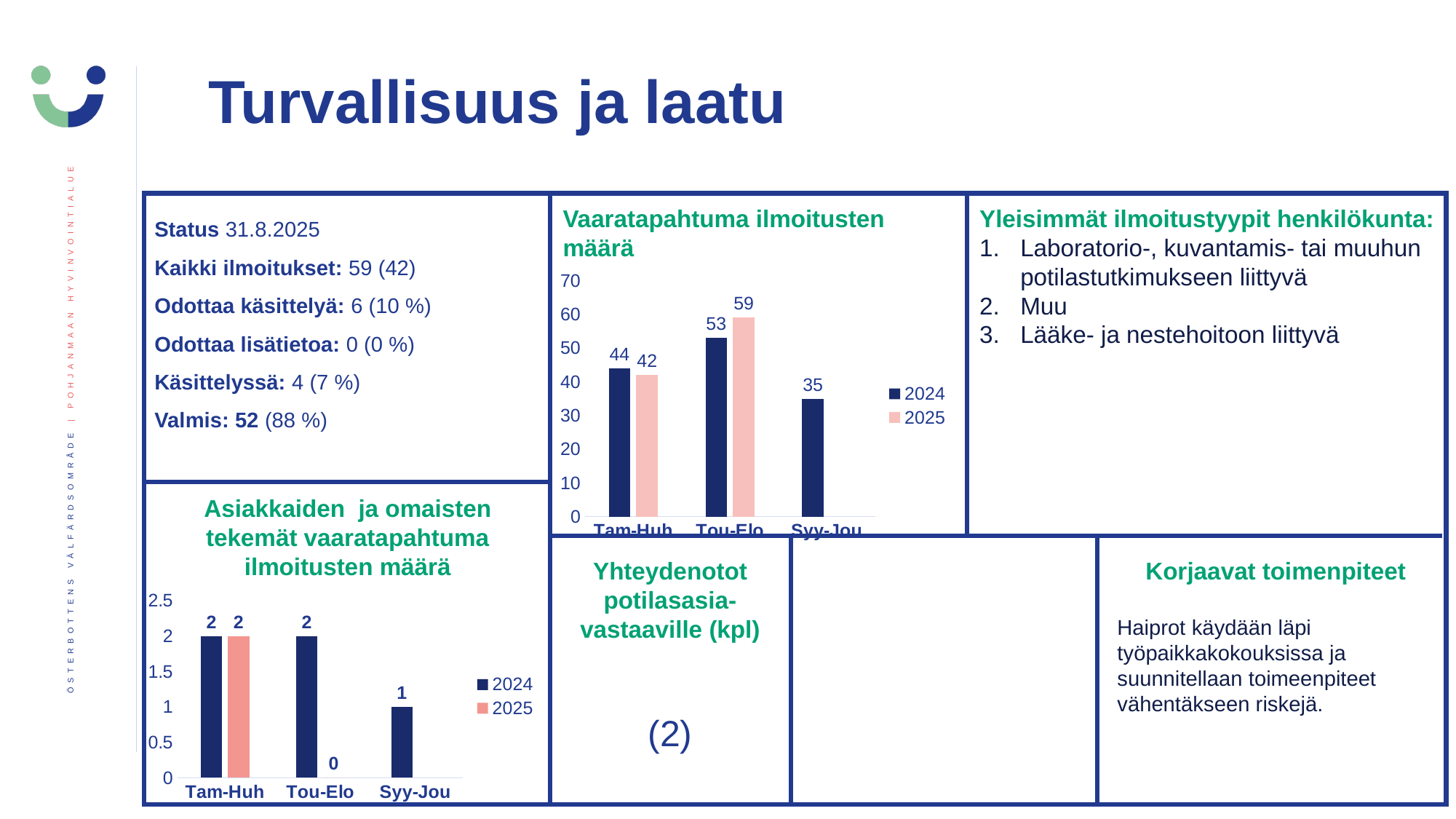
In the chart titled "Asiakkaiden ja omaisten tekemät vaaratapahtuma ilmoitusten määrä", what colour are the 2025 bars? pink In the chart titled "Vaaratapahtuma ilmoitusten määrä", what is the highest value shown on the vertical axis? 70 In the chart titled "Asiakkaiden ja omaisten tekemät vaaratapahtuma ilmoitusten määrä", what is the 2024 value for Syy-Jou? 1 In the chart titled "Asiakkaiden ja omaisten tekemät vaaratapahtuma ilmoitusten määrä", how many periods are shown on the x axis? 3 In the chart titled "Vaaratapahtuma ilmoitusten määrä", which period has the lowest 2024 value? Syy-Jou In the chart titled "Vaaratapahtuma ilmoitusten määrä", what is the 2025 value for Tam-Huh? 42 In the chart titled "Vaaratapahtuma ilmoitusten määrä", which is larger for Tam-Huh: the 2024 value or the 2025 value? 2024 In the chart titled "Vaaratapahtuma ilmoitusten määrä", what is the difference between the 2025 and 2024 values for Tou-Elo? 6 In the chart titled "Vaaratapahtuma ilmoitusten määrä", what is the 2024 value for Tou-Elo? 53 What kind of chart is "Asiakkaiden ja omaisten tekemät vaaratapahtuma ilmoitusten määrä"? bar chart In the chart titled "Vaaratapahtuma ilmoitusten määrä", how many series does the legend list? 2 In the chart titled "Asiakkaiden ja omaisten tekemät vaaratapahtuma ilmoitusten määrä", what is the 2025 value for Tou-Elo? 0